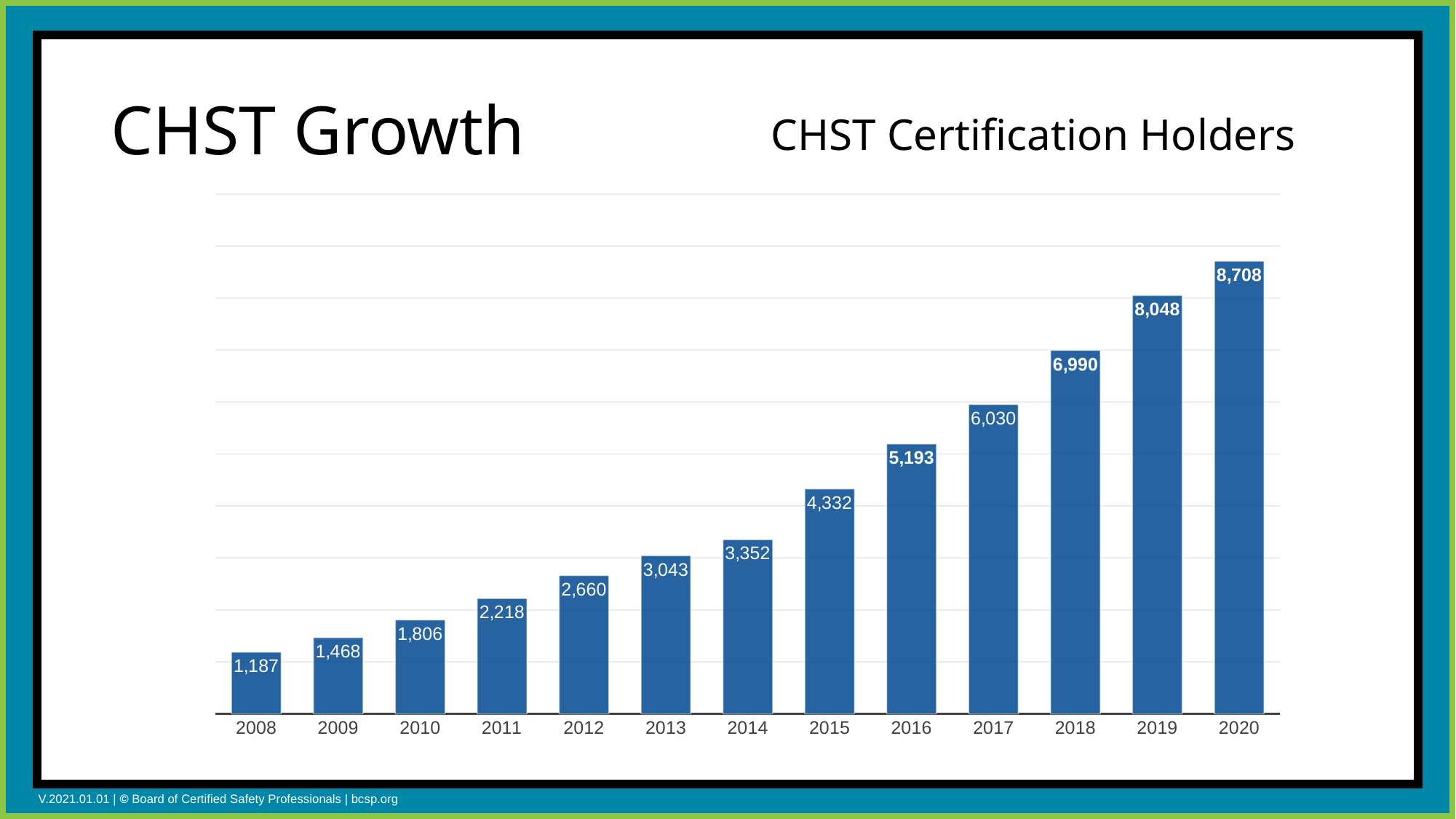
Do the values rise or fall from 2008 to 2020? Rise What kind of chart is shown on the slide? Bar chart What is the number of CHST certification holders in 2014? 3,352 Which year has the highest number of CHST certification holders? 2020 What is the difference in CHST certification holders between 2017 and 2016? 837 What is the number of CHST certification holders in 2019? 8,048 What is the number of CHST certification holders in 2008? 1,187 What is the difference in CHST certification holders between 2020 and 2019? 660 Which year has the lowest number of CHST certification holders? 2008 Which year has more CHST certification holders, 2012 or 2015? 2015 How many years are shown on the x axis of the chart? 13 What is the title of the chart? CHST Certification Holders